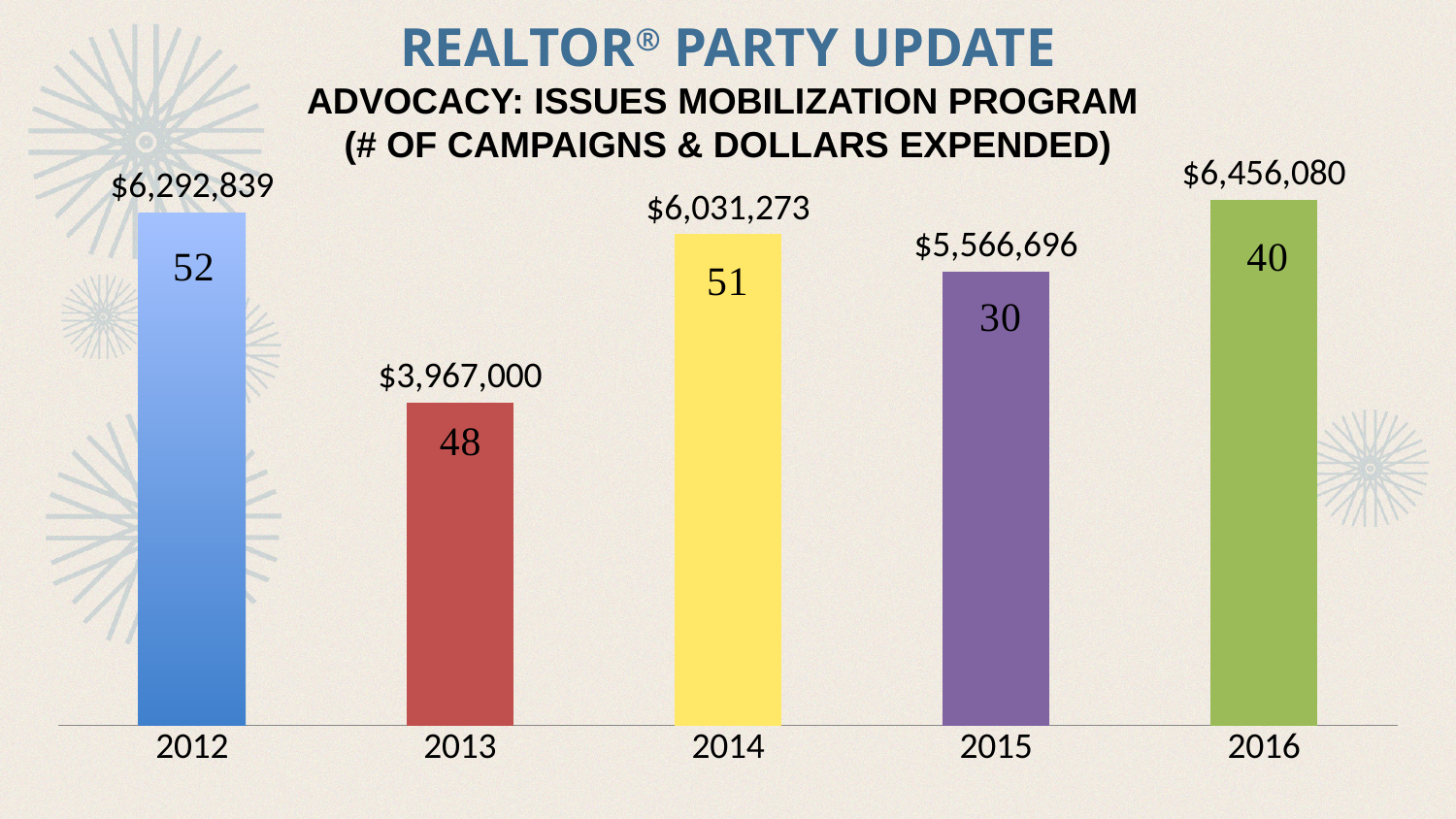
Which year had the fewest campaigns? 2015 What is the difference in dollars expended between 2016 and 2012? $163,241 How many campaigns are shown for 2014? 51 Which year had the lowest dollars expended? 2013 What type of chart is shown on the slide? Bar chart Which year had more dollars expended, 2014 or 2015? 2014 Which year had the highest dollars expended? 2016 How many years are shown on the chart? 5 How many campaigns are shown for 2015? 30 How many more campaigns were there in 2012 than in 2015? 22 What were the dollars expended in 2013? $3,967,000 What were the dollars expended in 2016? $6,456,080